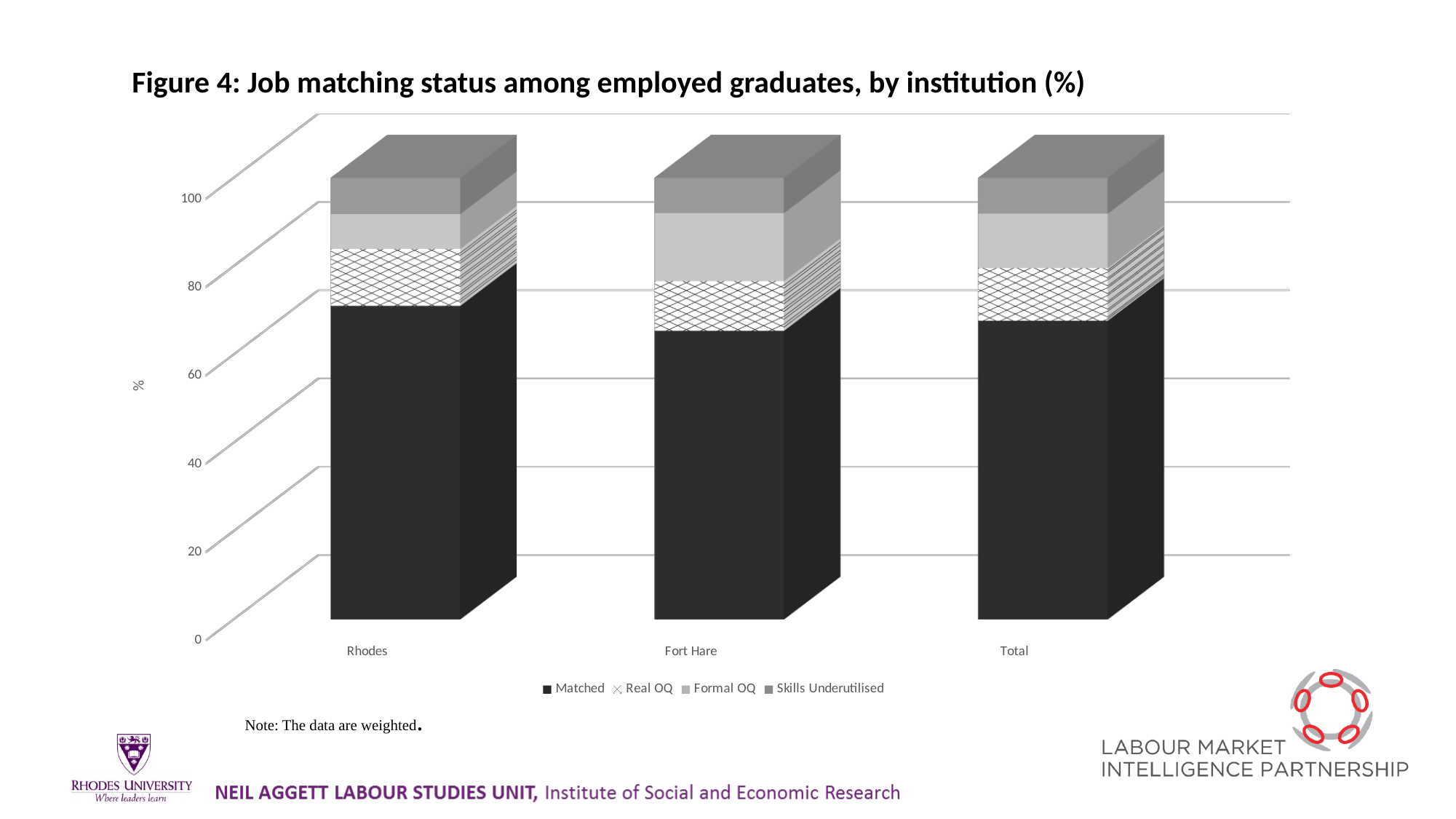
Is the Matched value for Total greater or less than 60? greater Is the Matched value for Rhodes greater or less than 60? greater What is the title of the chart? Figure 4: Job matching status among employed graduates, by institution (%) What kind of chart is shown on the slide? Stacked bar chart Is the Matched value for Fort Hare greater or less than 80? less Which institution has the lowest Matched share? Fort Hare Which has the larger Matched segment, Rhodes or Fort Hare? Rhodes Which institution has the highest Matched share? Rhodes How many series does the legend list? 4 Which has the larger Formal OQ segment, Rhodes or Fort Hare? Fort Hare What are the four series listed in the legend? Matched, Real OQ, Formal OQ, Skills Underutilised How many institutions (categories) are shown on the x axis? 3